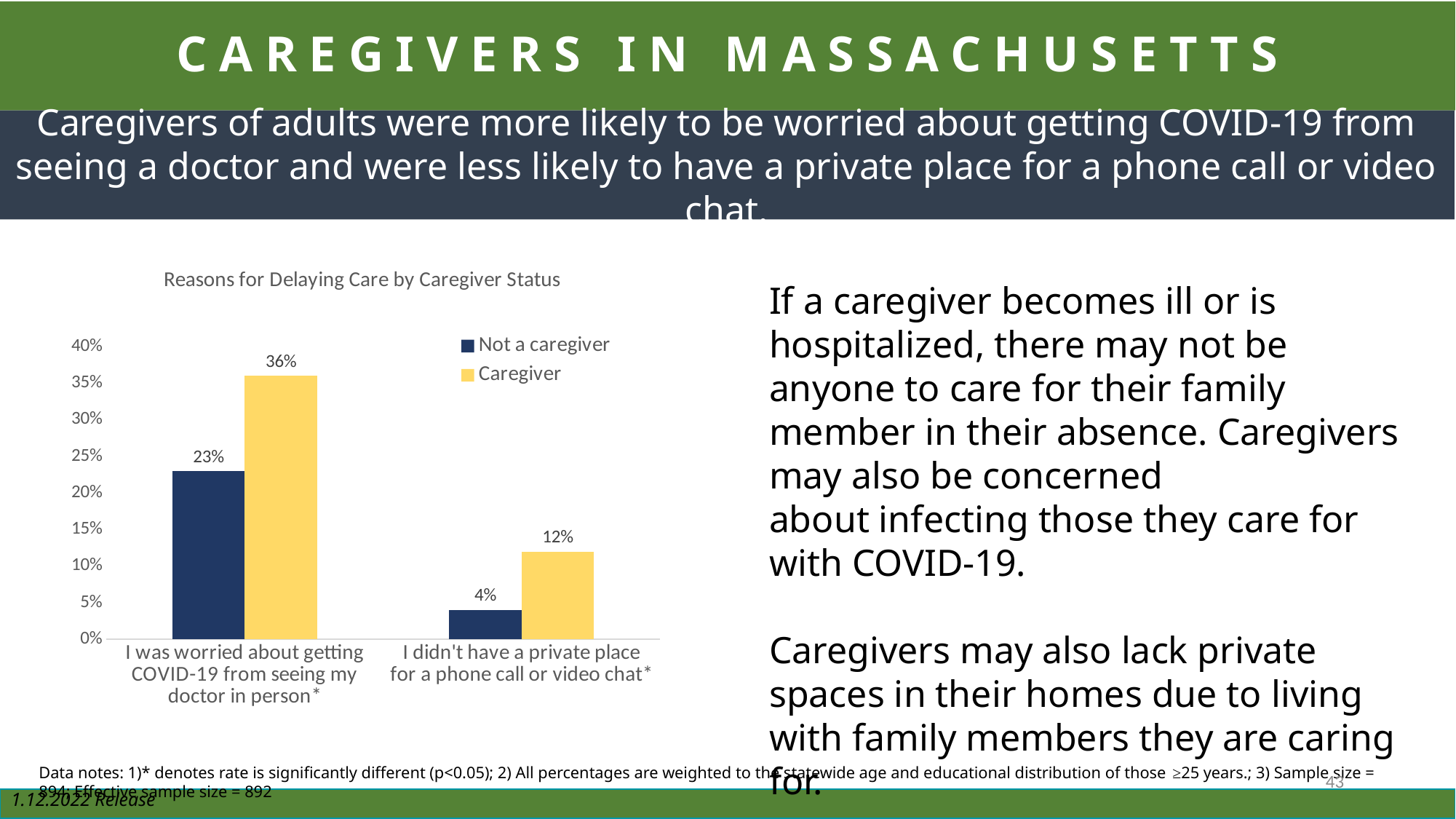
How many series does the legend list? 2 What percentage of non-caregivers didn't have a private place for a phone call or video chat? 4% What is the difference between caregivers and non-caregivers for not having a private place for a phone call or video chat? 8 percentage points What is the difference between caregivers and non-caregivers for being worried about getting COVID-19 from seeing a doctor in person? 13 percentage points What is the lowest value shown in the chart? 4% What percentage of caregivers didn't have a private place for a phone call or video chat? 12% Which group has a higher value for not having a private place for a phone call or video chat? Caregiver What is the title of the chart? Reasons for Delaying Care by Caregiver Status What kind of chart is shown on the slide? Bar chart Which group has the highest value in the chart? Caregiver What percentage of non-caregivers were worried about getting COVID-19 from seeing their doctor in person? 23% What percentage of caregivers were worried about getting COVID-19 from seeing their doctor in person? 36%